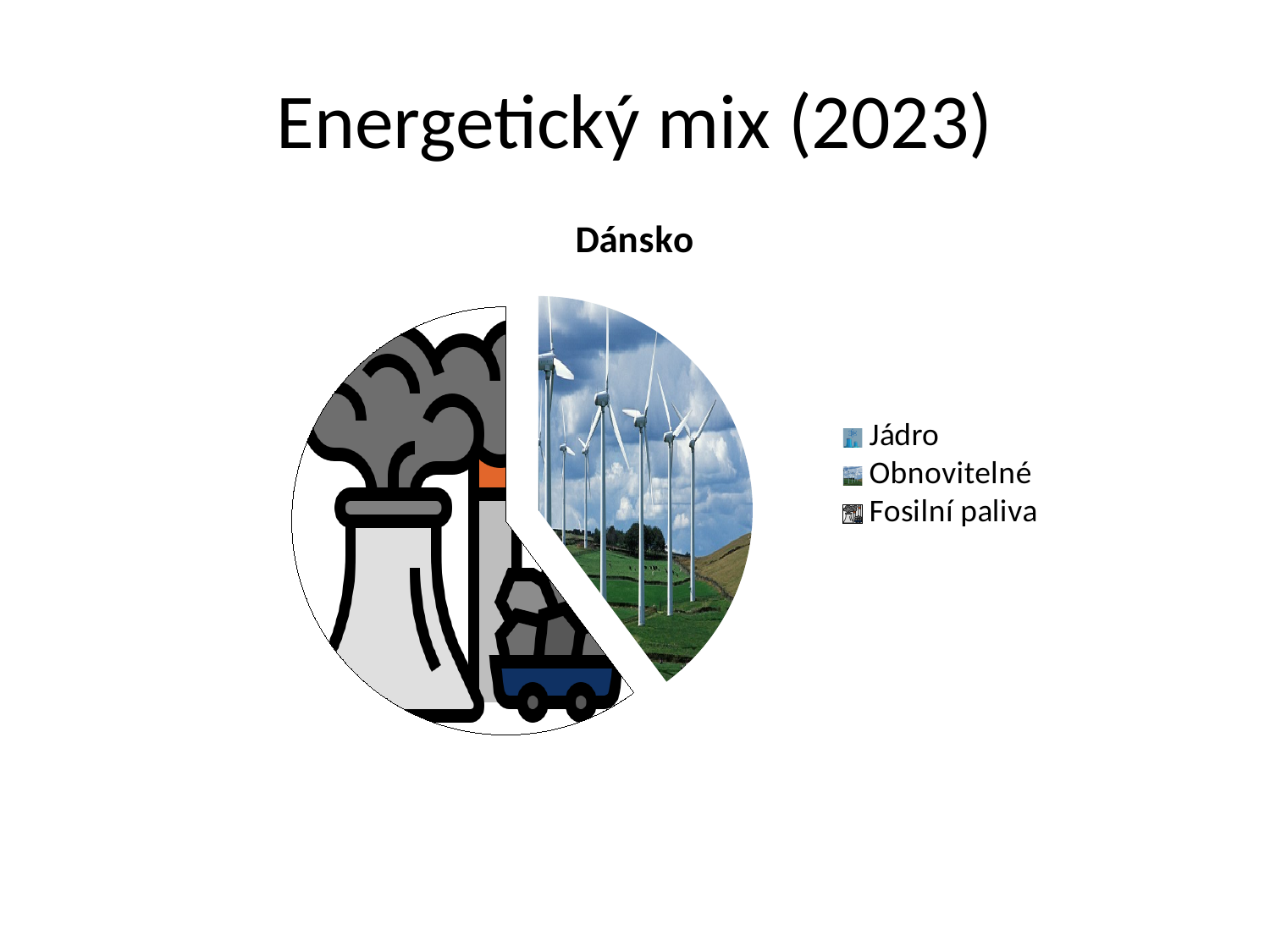
Which categories are listed in the legend of the pie chart? Jádro, Obnovitelné, Fosilní paliva Which category has the smallest share in the pie chart? Jádro Is the share of Fosilní paliva in the pie chart greater or less than 50%? greater Which category has the largest slice in the pie chart? Fosilní paliva What kind of chart is shown on the slide? pie chart What is the title of the pie chart? Dánsko Which slice is larger in the pie chart, Fosilní paliva or Obnovitelné? Fosilní paliva Is the share of Obnovitelné in the pie chart greater or less than 50%? less How many entries does the legend of the pie chart list? 3